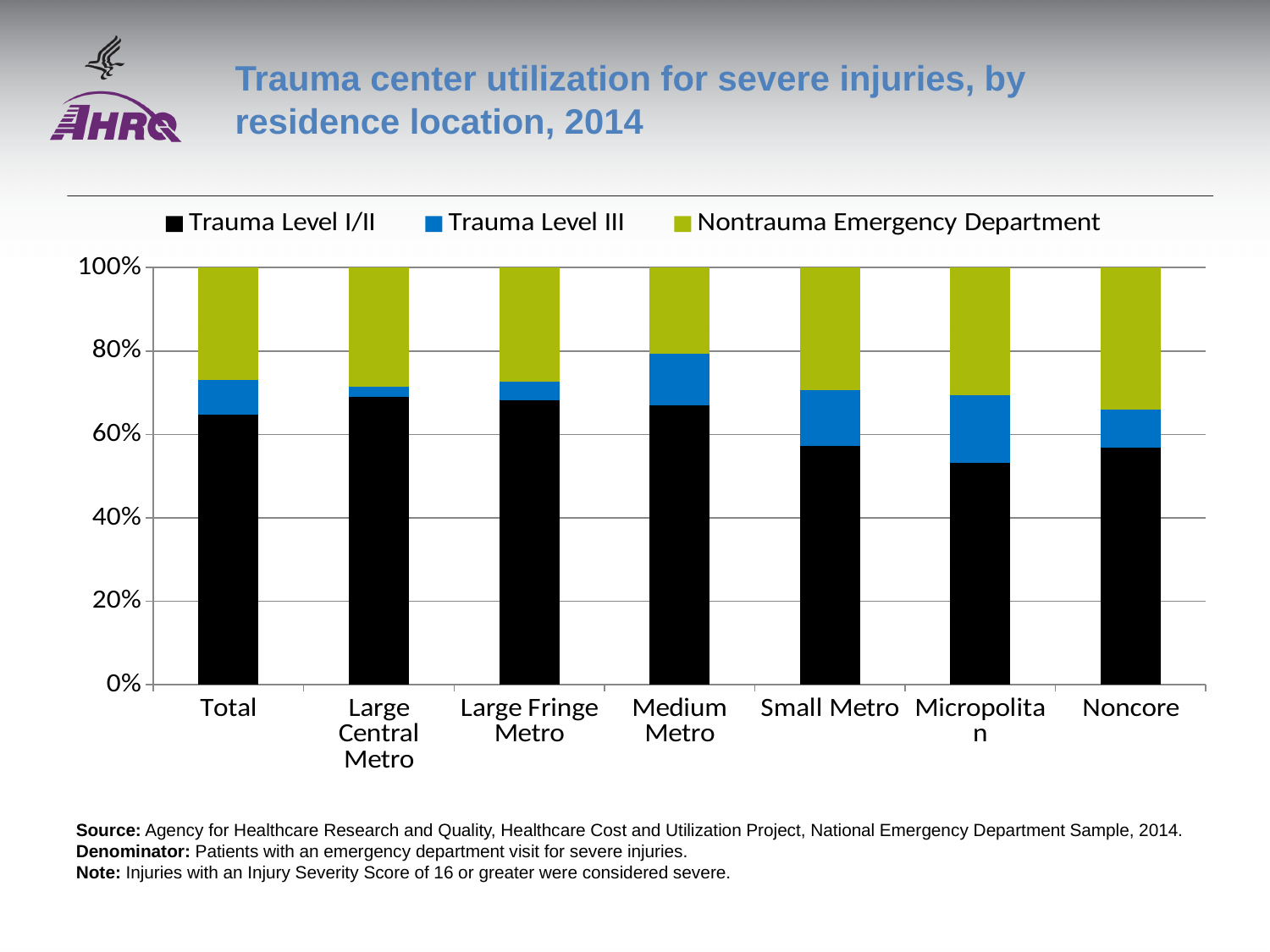
How many residence location categories are shown along the x axis? 7 Is the Trauma Level I/II value for Total greater or less than 60%? greater Which has a larger Trauma Level I/II share, Large Central Metro or Micropolitan? Large Central Metro What kind of chart is shown on the slide? Stacked bar chart Which colour represents Nontrauma Emergency Department in the legend? Green Which residence location has the smallest Trauma Level III segment? Large Central Metro Which residence location has the lowest Trauma Level I/II share? Micropolitan Is the Trauma Level I/II value for Large Central Metro greater or less than 60%? greater Is the Trauma Level I/II value for Micropolitan greater or less than 60%? less How many series does the legend list? 3 Which residence location has the smallest Nontrauma Emergency Department segment? Medium Metro